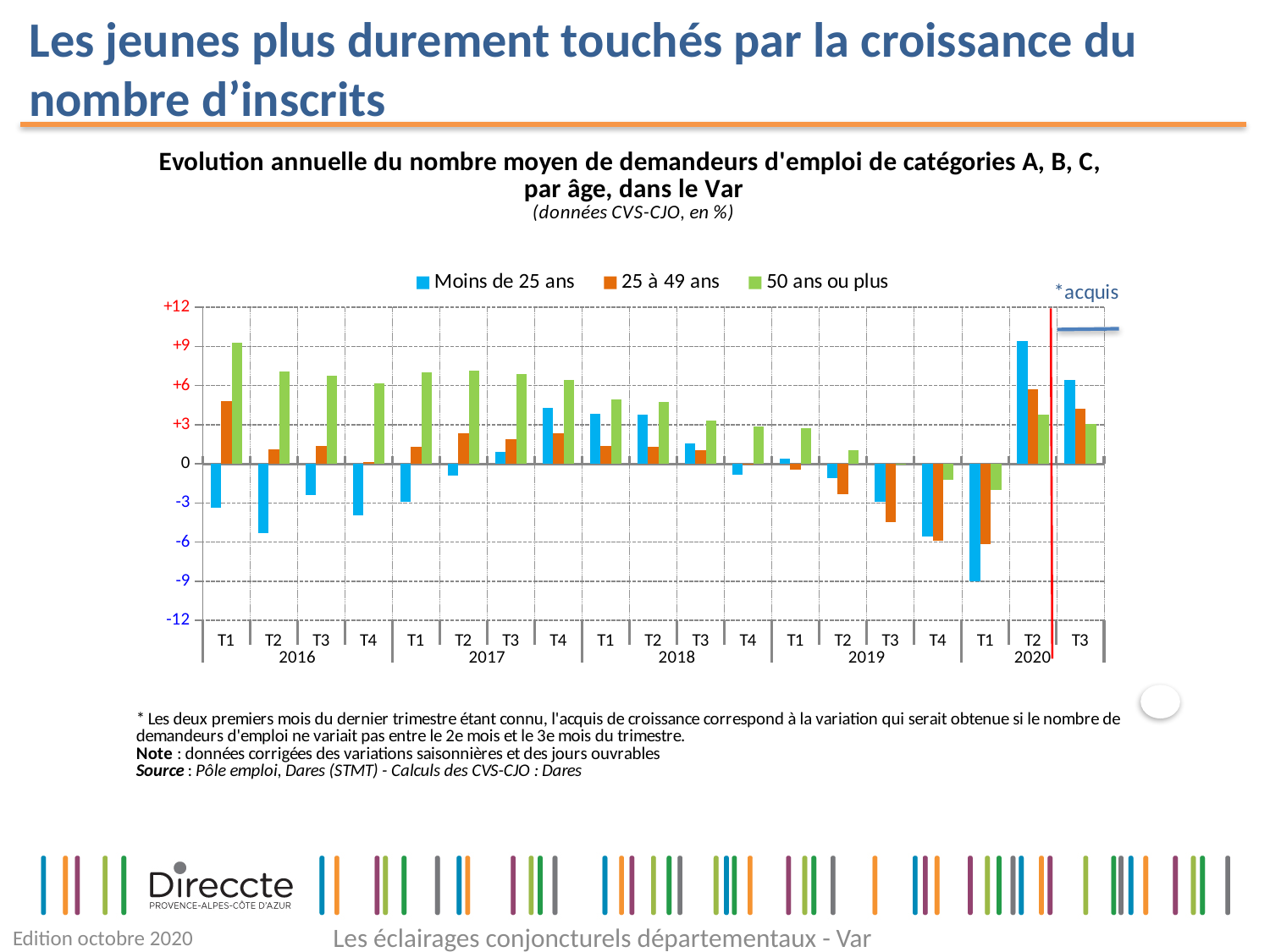
Does the value for '50 ans ou plus' rise or fall from T1 2016 to T1 2020? fall What kind of chart is shown on the slide? bar chart Is the value for 'Moins de 25 ans' in T2 2020 greater or less than +6? greater How many quarters are plotted on the x axis? 19 How many series does the legend list? 3 What colour represents the 'Moins de 25 ans' series? blue In which quarter is the value for 'Moins de 25 ans' the lowest? T1 2020 In which quarter is the value for 'Moins de 25 ans' the highest? T2 2020 Is the value for 'Moins de 25 ans' in T1 2020 greater or less than -6? less In T2 2020, which series has the larger value: 'Moins de 25 ans' or '50 ans ou plus'? Moins de 25 ans Is the value for '50 ans ou plus' in T2 2016 greater or less than +6? greater In which quarter is the value for '50 ans ou plus' the highest? T1 2016